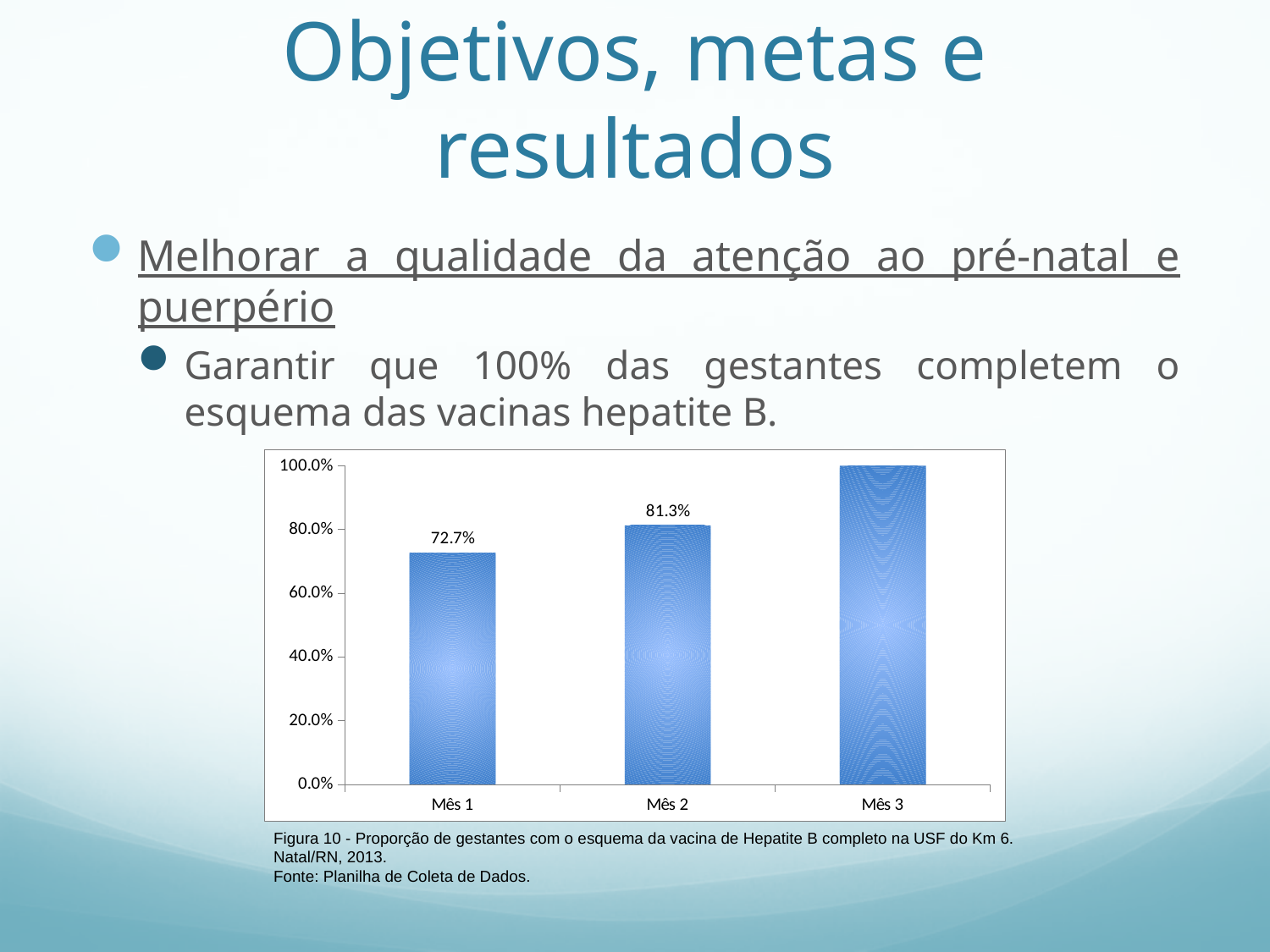
Which month has the lowest value? Mês 1 Is the value for Mês 3 greater or less than 80.0%? greater Do the values rise or fall from Mês 1 to Mês 3? rise What is the value for Mês 1? 72.7% What is the highest value shown on the y axis? 100.0% What is the difference between the values for Mês 2 and Mês 1? 8.6 percentage points What is the value for Mês 2? 81.3% Is the value for Mês 1 greater or less than 60.0%? greater How many months are shown on the x axis? 3 What kind of chart is shown on the slide? bar chart Which is larger, the value for Mês 1 or the value for Mês 2? Mês 2 Which month has the highest value? Mês 3